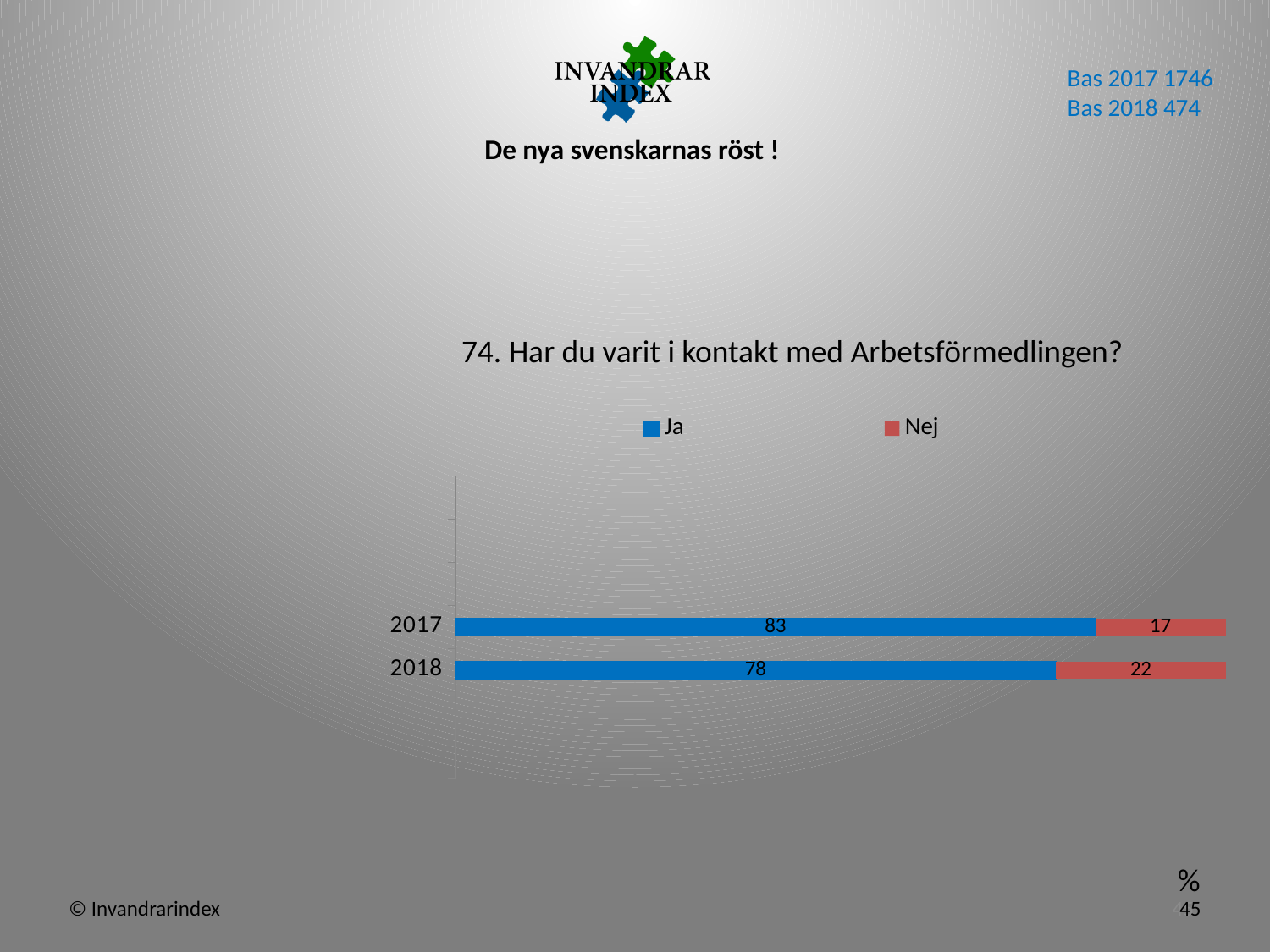
What kind of chart is shown? Stacked bar chart What is the value for Ja in 2018? 78 How many years are shown on the chart? 2 Which year has the higher value for Ja? 2017 What is the value for Nej in 2017? 17 What is the value for Ja in 2017? 83 What is the difference between the Ja values for 2017 and 2018? 5 What is the total of the stacked bar for 2018? 100 How many series does the legend list? 2 Which year has the lower value for Nej? 2017 Is the Nej value larger in 2017 or 2018? 2018 What is the value for Nej in 2018? 22